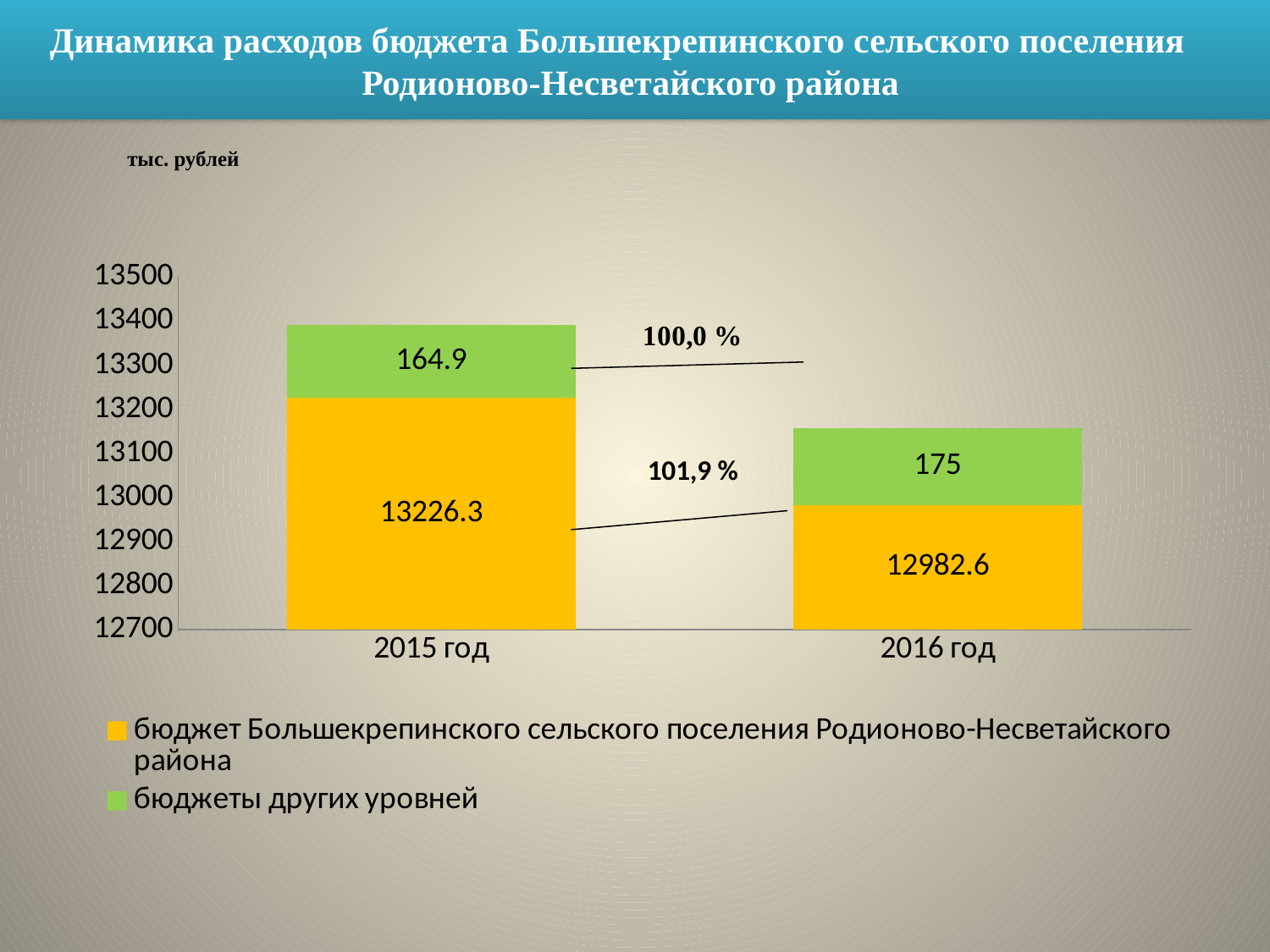
What is the difference between the 'бюджеты других уровней' values for 2016 год and 2015 год? 10.1 What is the value for 'бюджет Большекрепинского сельского поселения Родионово-Несветайского района' in 2015 год? 13226.3 How many years (categories) are shown on the x axis? 2 What is the value for 'бюджеты других уровней' in 2016 год? 175 What is the difference between the 'бюджет Большекрепинского сельского поселения Родионово-Несветайского района' values for 2015 год and 2016 год? 243.7 What is the total of the two series for 2015 год? 13391.2 What is the value for 'бюджет Большекрепинского сельского поселения Родионово-Несветайского района' in 2016 год? 12982.6 What is the value for 'бюджеты других уровней' in 2015 год? 164.9 Which year has the higher value for 'бюджеты других уровней', 2015 год or 2016 год? 2016 год How many series does the legend list? 2 Which year has the higher value for 'бюджет Большекрепинского сельского поселения Родионово-Несветайского района', 2015 год or 2016 год? 2015 год What kind of chart is shown on the slide? Stacked bar chart